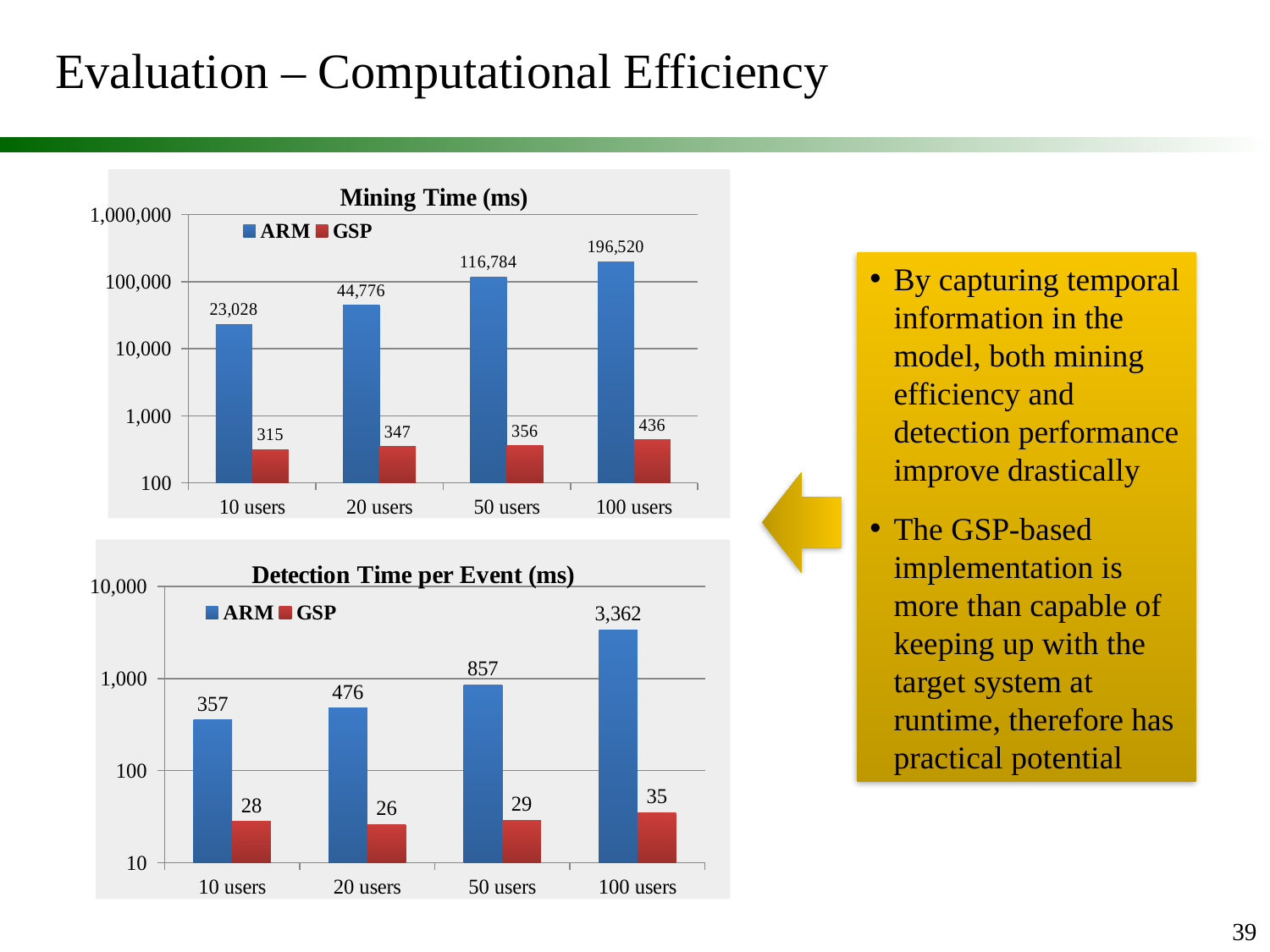
In the 'Detection Time per Event (ms)' chart, do the ARM values rise or fall as the number of users increases? rise In the 'Mining Time (ms)' chart, what is the ARM value for 50 users? 116,784 In the 'Detection Time per Event (ms)' chart, what is the ARM value for 100 users? 3,362 In the 'Mining Time (ms)' chart, how many series does the legend list? 2 In the 'Detection Time per Event (ms)' chart, what is the difference between the ARM values for 50 users and 20 users? 381 In the 'Detection Time per Event (ms)' chart, what is the GSP value for 20 users? 26 In the 'Detection Time per Event (ms)' chart, how many user-count categories are shown on the x axis? 4 In the 'Mining Time (ms)' chart, which user count has the highest ARM mining time? 100 users What kind of chart is the 'Mining Time (ms)' chart? bar chart In the 'Mining Time (ms)' chart, what is the GSP value for 100 users? 436 In the 'Mining Time (ms)' chart, what is the difference between the ARM and GSP values for 10 users? 22,713 In the 'Detection Time per Event (ms)' chart, which user count has the lowest GSP detection time? 20 users